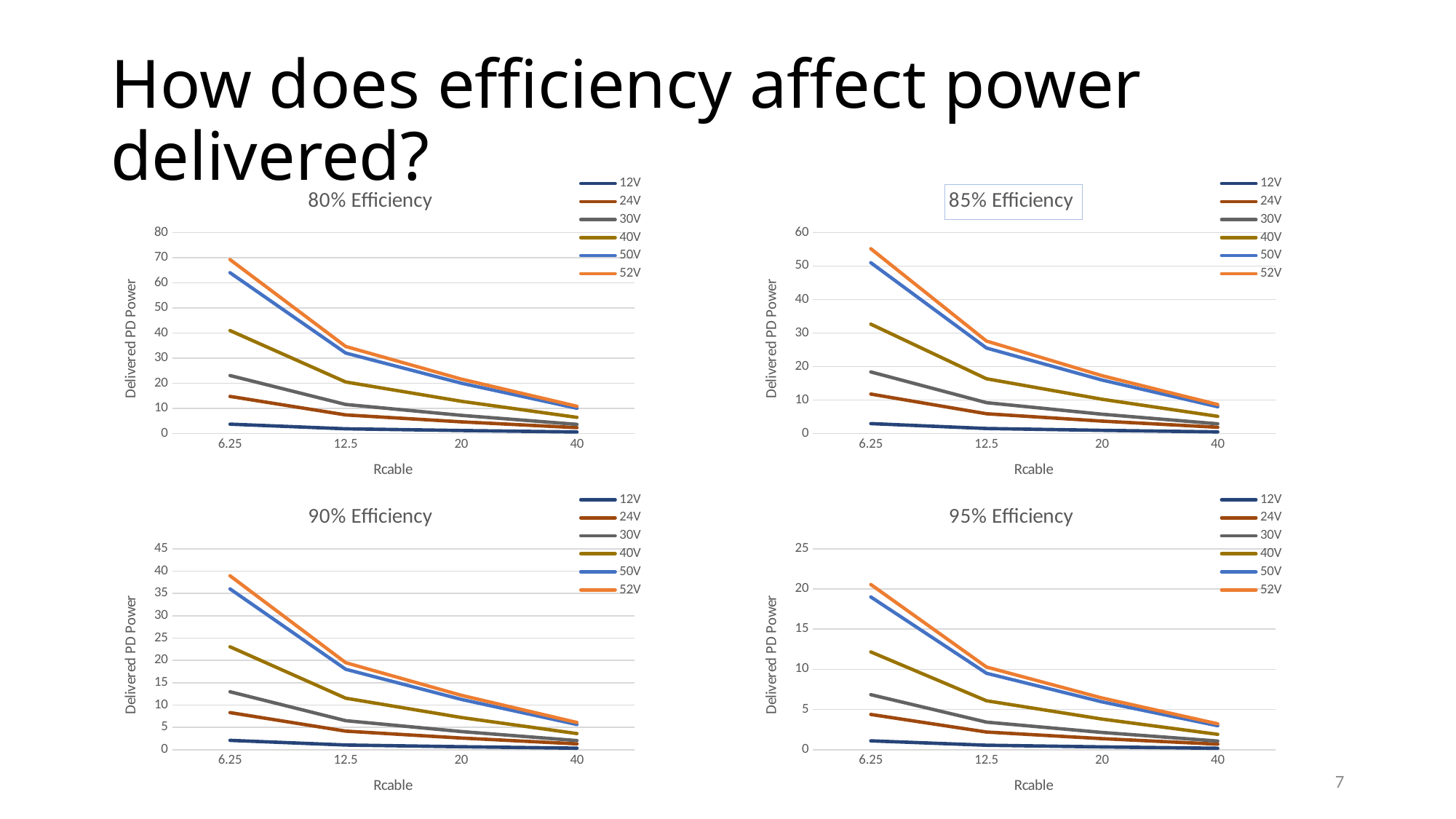
In the "85% Efficiency" chart, is the value for 40V at Rcable 6.25 greater or less than 20? greater In the "90% Efficiency" chart, is the value for 12V at Rcable 6.25 greater or less than 5? less What is the y-axis label of the "95% Efficiency" chart? Delivered PD Power In the "80% Efficiency" chart, which series has the highest Delivered PD Power at Rcable 6.25? 52V What kind of chart is the "80% Efficiency" chart? line chart In the "90% Efficiency" chart, which is larger at Rcable 6.25: the value for 40V or the value for 30V? 40V In the "95% Efficiency" chart, is the value for 52V at Rcable 6.25 greater or less than 15? greater How many Rcable values are plotted along the x axis of the "90% Efficiency" chart? 4 In the "95% Efficiency" chart, does the 52V line rise or fall as Rcable increases? fall In the "85% Efficiency" chart, which series has the lowest Delivered PD Power at Rcable 6.25? 12V How many series does the legend of the "85% Efficiency" chart list? 6